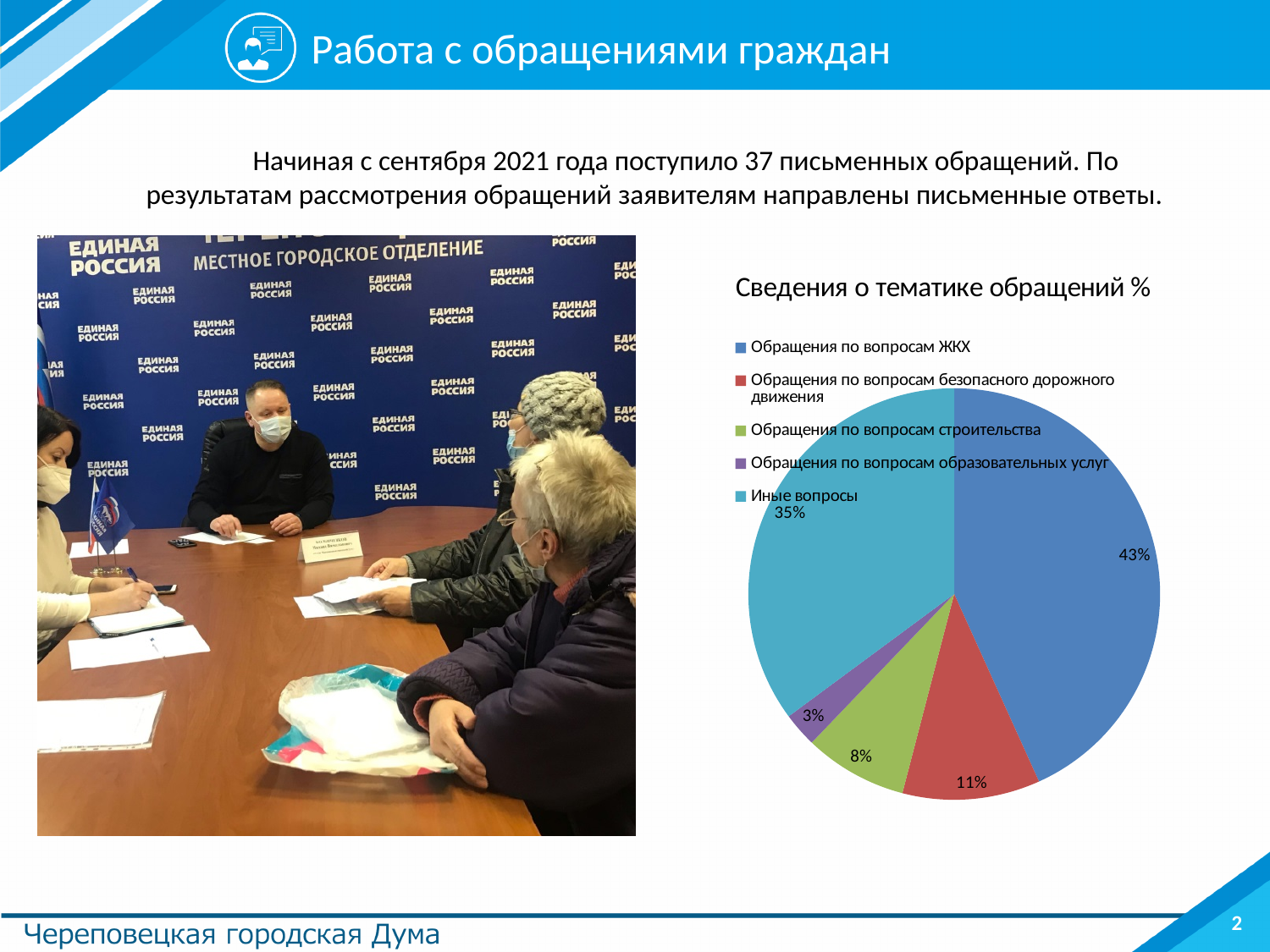
Which is larger: the share for 'Обращения по вопросам безопасного дорожного движения' or for 'Обращения по вопросам строительства'? Обращения по вопросам безопасного дорожного движения Which category has the smallest share of the pie? Обращения по вопросам образовательных услуг What type of chart is shown on the slide? Pie chart Which category has the largest share of the pie? Обращения по вопросам ЖКХ What is the title of the chart? Сведения о тематике обращений % What is the difference in percentage points between 'Обращения по вопросам ЖКХ' and 'Иные вопросы'? 8 What share of the pie is 'Обращения по вопросам образовательных услуг'? 3% What share of the pie is 'Обращения по вопросам безопасного дорожного движения'? 11% What share of the pie is 'Иные вопросы'? 35% How many categories does the pie chart legend list? 5